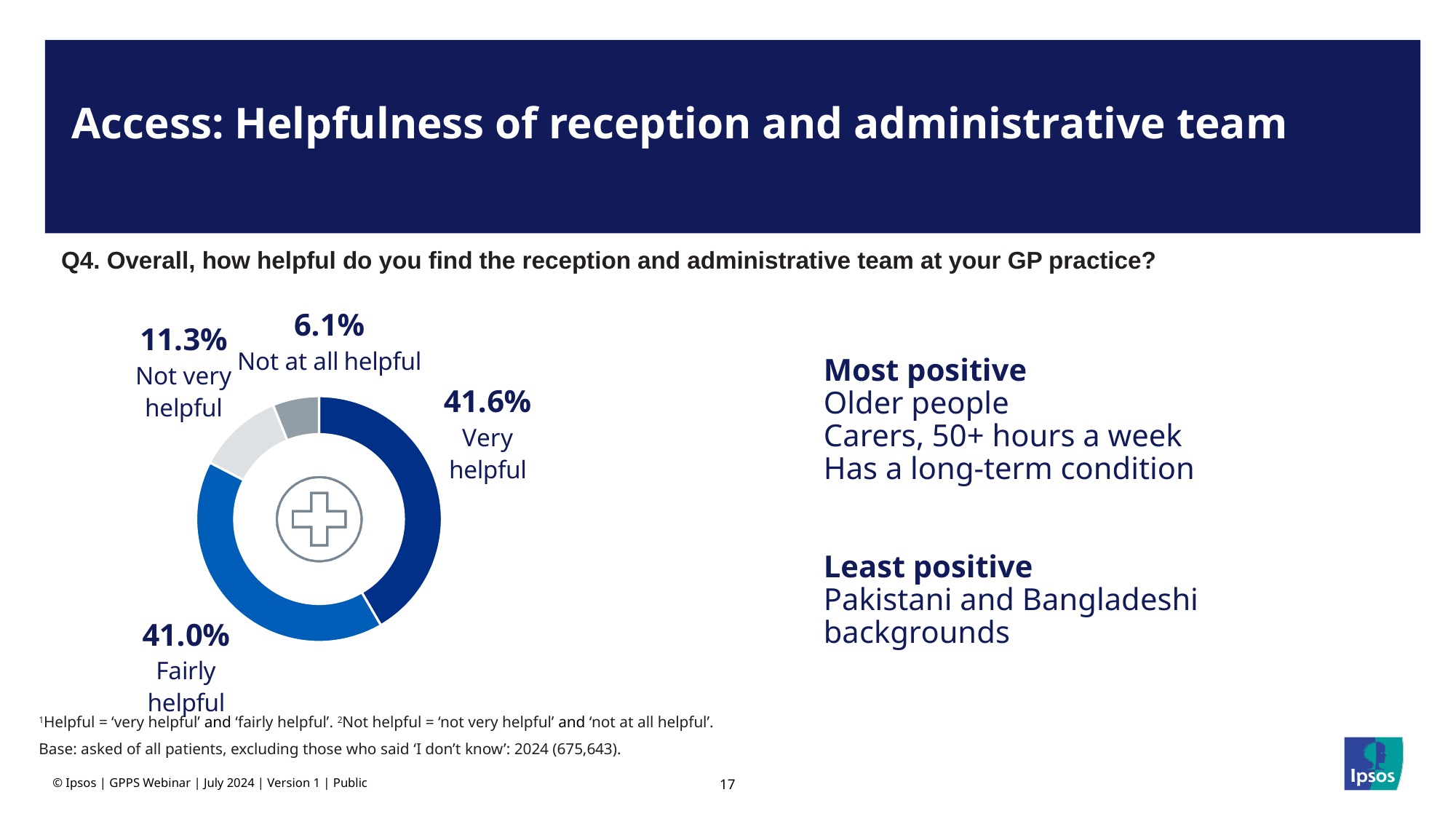
What percentage of patients said the reception and administrative team was not at all helpful? 6.1% What is the combined share of 'Very helpful' and 'Fairly helpful' responses? 82.6% Which response category has the largest share in the chart? Very helpful What percentage of patients said the reception and administrative team was not very helpful? 11.3% Which response category has the smallest share in the chart? Not at all helpful What kind of chart is used to show the responses to Q4? Donut (pie) chart What is the difference in percentage points between 'Very helpful' and 'Fairly helpful'? 0.6 percentage points What is the difference in percentage points between 'Not very helpful' and 'Not at all helpful'? 5.2 percentage points What percentage of patients said the reception and administrative team was fairly helpful? 41.0% How many response categories are shown in the chart? 4 Which is larger, the share for 'Not very helpful' or the share for 'Not at all helpful'? Not very helpful What percentage of patients said the reception and administrative team was very helpful? 41.6%